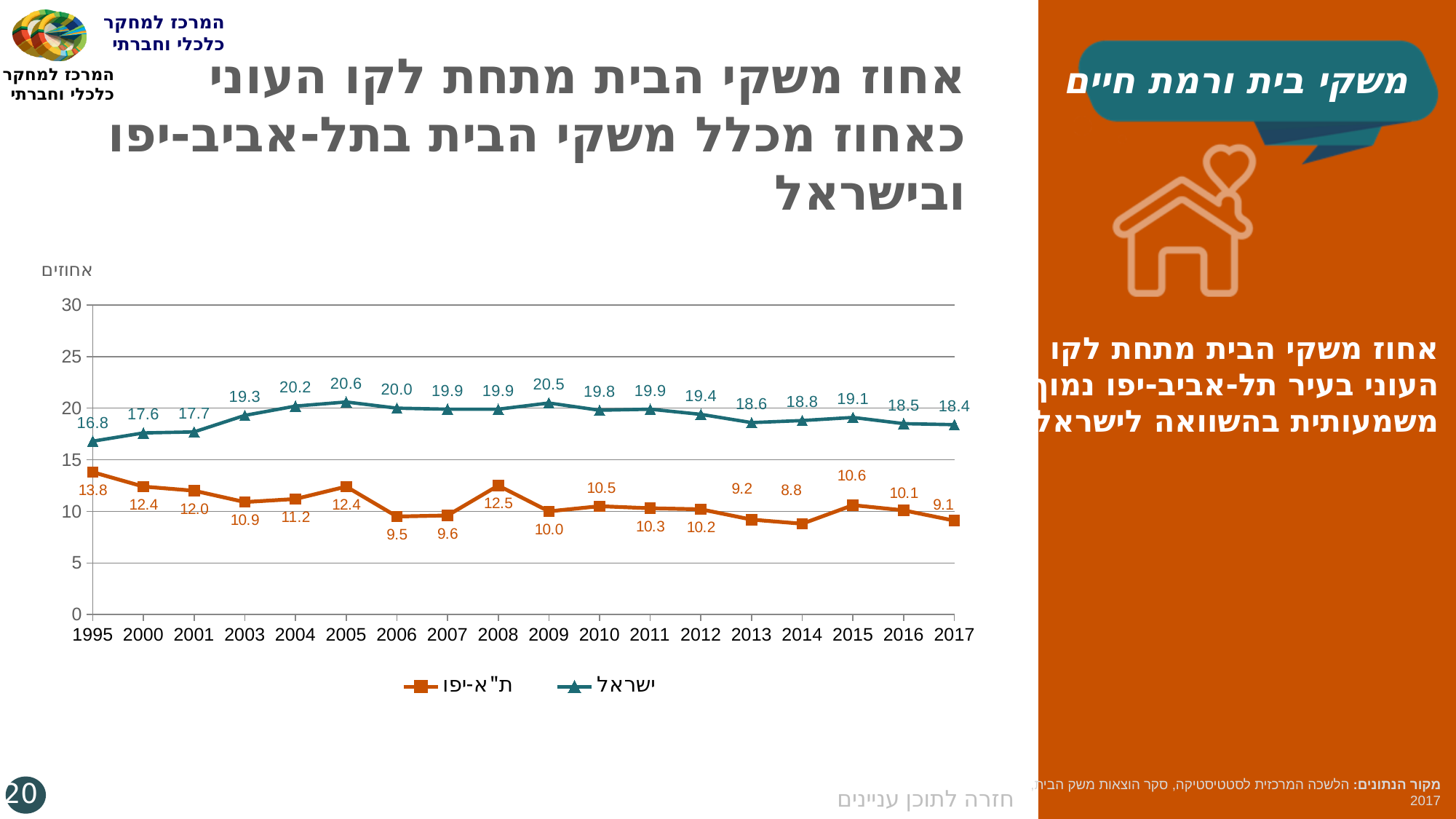
In which year is the ת"א-יפו series at its highest? 1995 Which series has the higher value in 2008, ישראל or ת"א-יפו? ישראל What is the label shown on the y axis? אחוזים What is the value for ישראל in 2005? 20.6 In which year is the ישראל series at its highest? 2005 In which year is the ת"א-יפו series at its lowest? 2014 What type of chart is shown on the slide? line chart What is the difference between the ישראל and ת"א-יפו values in 2017? 9.3 What is the value for ת"א-יפו in 2017? 9.1 What is the value for ת"א-יפו in 2014? 8.8 How many series does the legend list? 2 How many years are plotted along the x axis? 18